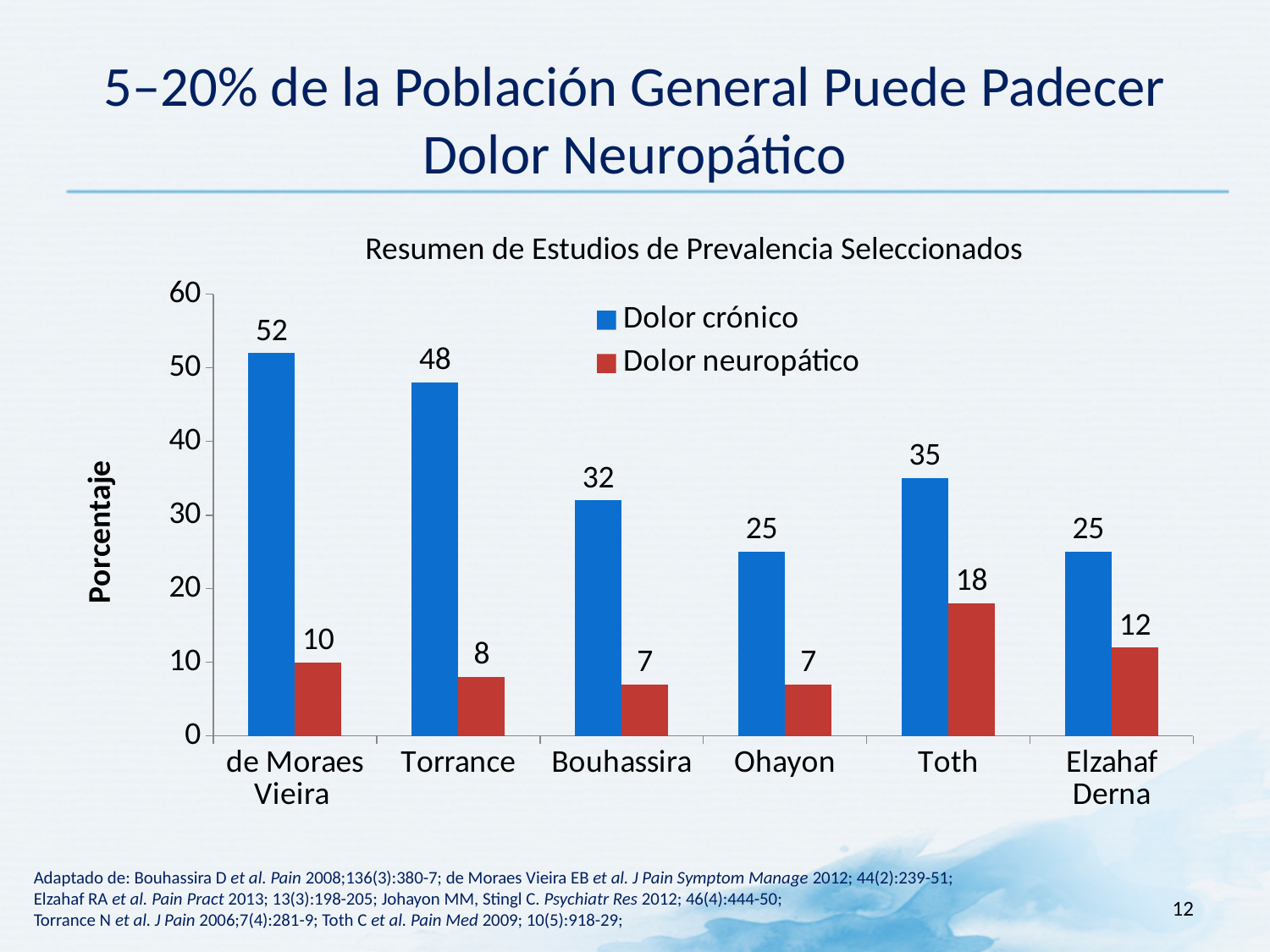
What is the Dolor crónico value for Torrance? 48 Which study has the highest Dolor crónico value? de Moraes Vieira What is the title of the chart? Resumen de Estudios de Prevalencia Seleccionados What is the difference between the Dolor crónico and Dolor neuropático values for de Moraes Vieira? 42 How many series does the legend list? 2 Which study has the lowest Dolor neuropático value? Bouhassira and Ohayon (both 7) What is the Dolor neuropático value for Toth? 18 How many studies are shown on the x axis? 6 Which is larger: the Dolor neuropático value for Elzahaf Derna or for Torrance? Elzahaf Derna Is the Dolor crónico value for Toth greater or less than 30? greater What is the label of the y axis? Porcentaje What kind of chart is shown? Bar chart